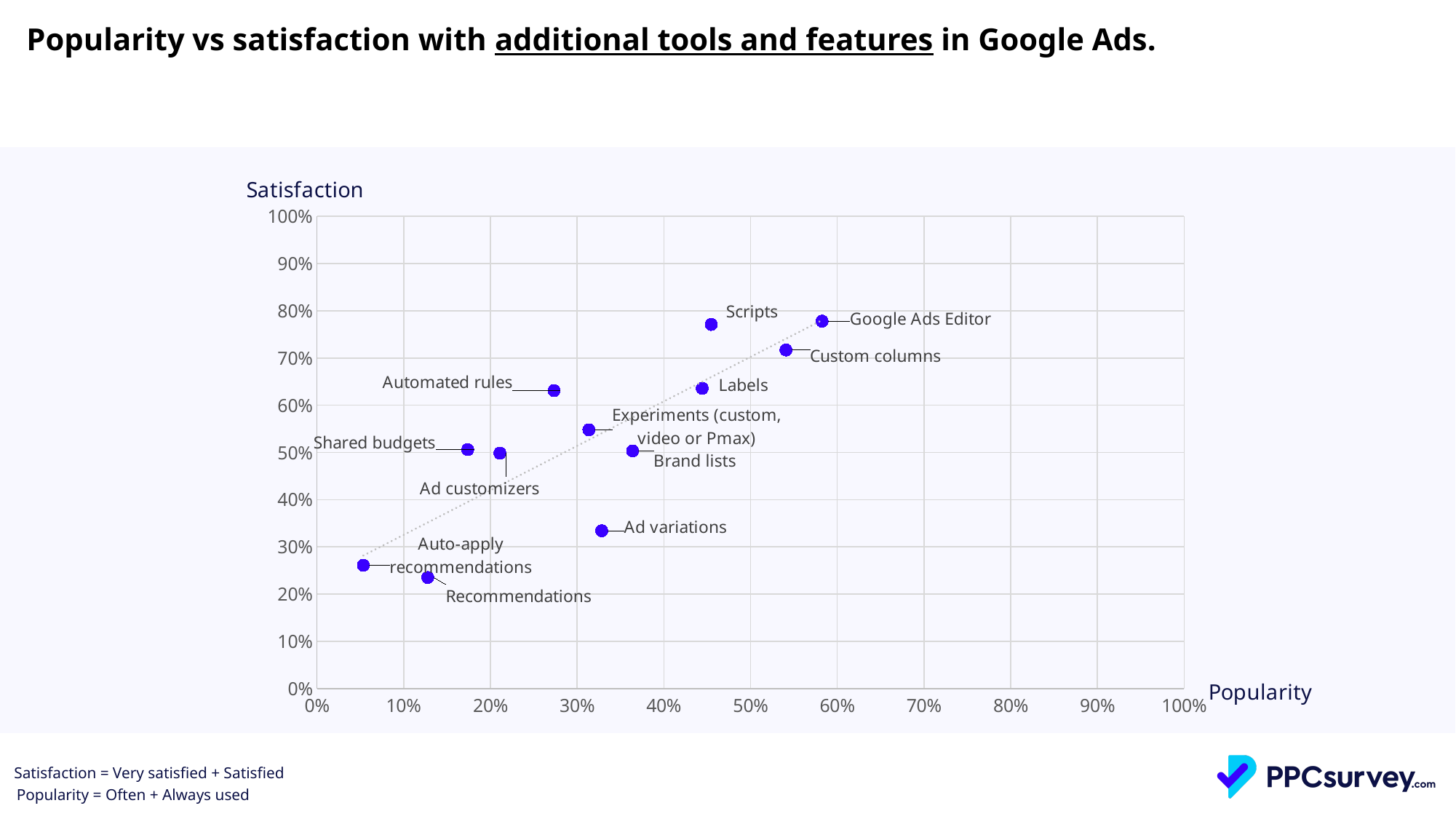
Which has the higher popularity, Custom columns or Labels? Custom columns Is the popularity value for Shared budgets greater or less than 20%? less What kind of chart is shown on the slide? Scatter chart Is the popularity value for Google Ads Editor greater or less than 50%? greater Is the satisfaction value for Scripts greater or less than 70%? greater Which has the higher satisfaction, Automated rules or Ad variations? Automated rules Which tool or feature has the highest popularity on the chart? Google Ads Editor Which tool or feature has the lowest popularity on the chart? Auto-apply recommendations How many tools or features are plotted as points on the chart? 12 What is the label of the vertical axis of the chart? Satisfaction